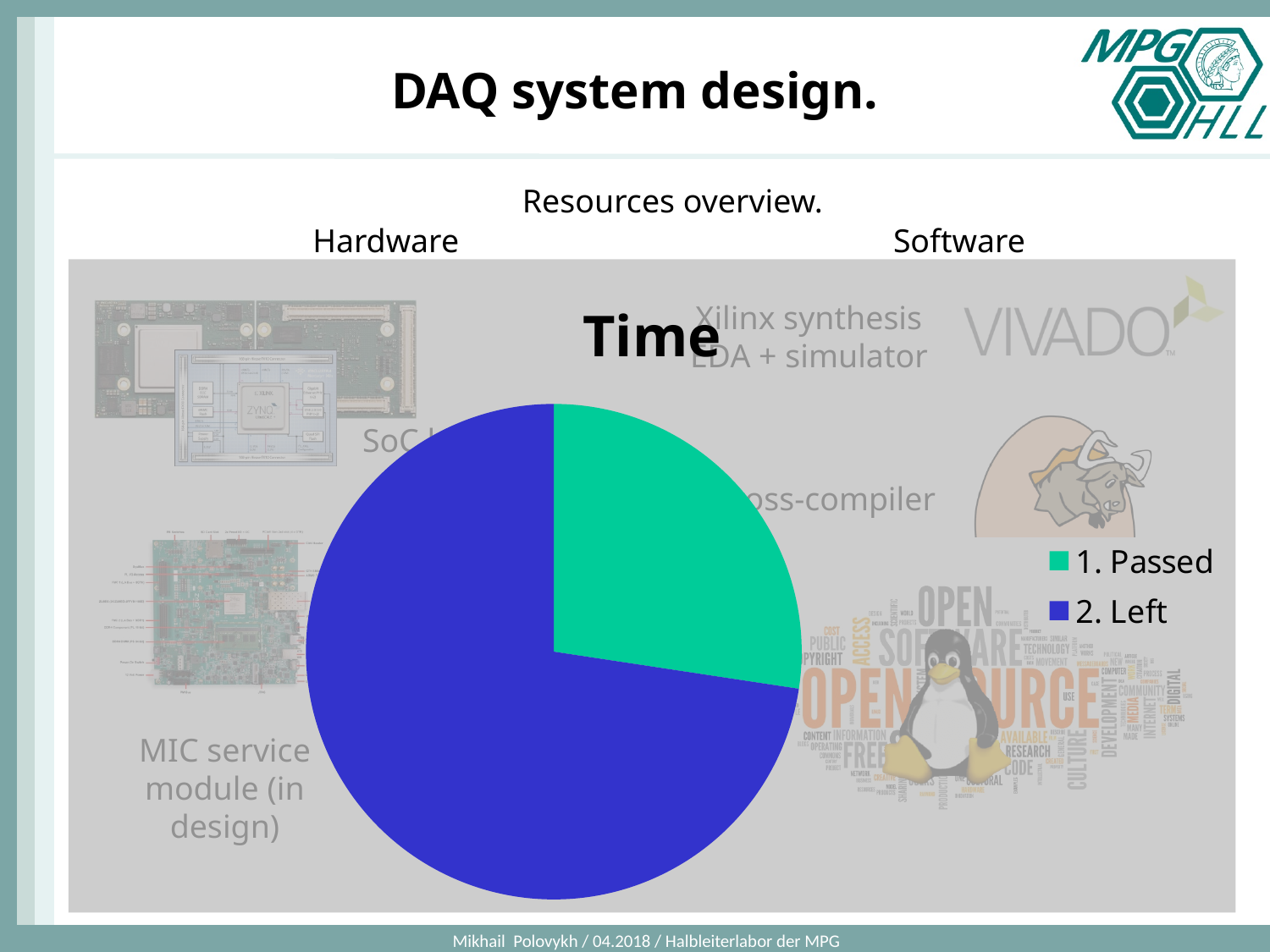
Which slice of the pie chart is the largest? 2. Left How many entries does the legend of the pie chart list? 2 What kind of chart is shown on the slide? pie chart Which slice of the pie chart is the smallest? 1. Passed What colour is the slice for 2. Left in the pie chart? blue How many slices does the pie chart have? 2 Which is larger in the pie chart, 1. Passed or 2. Left? 2. Left What is the title of the pie chart? Time